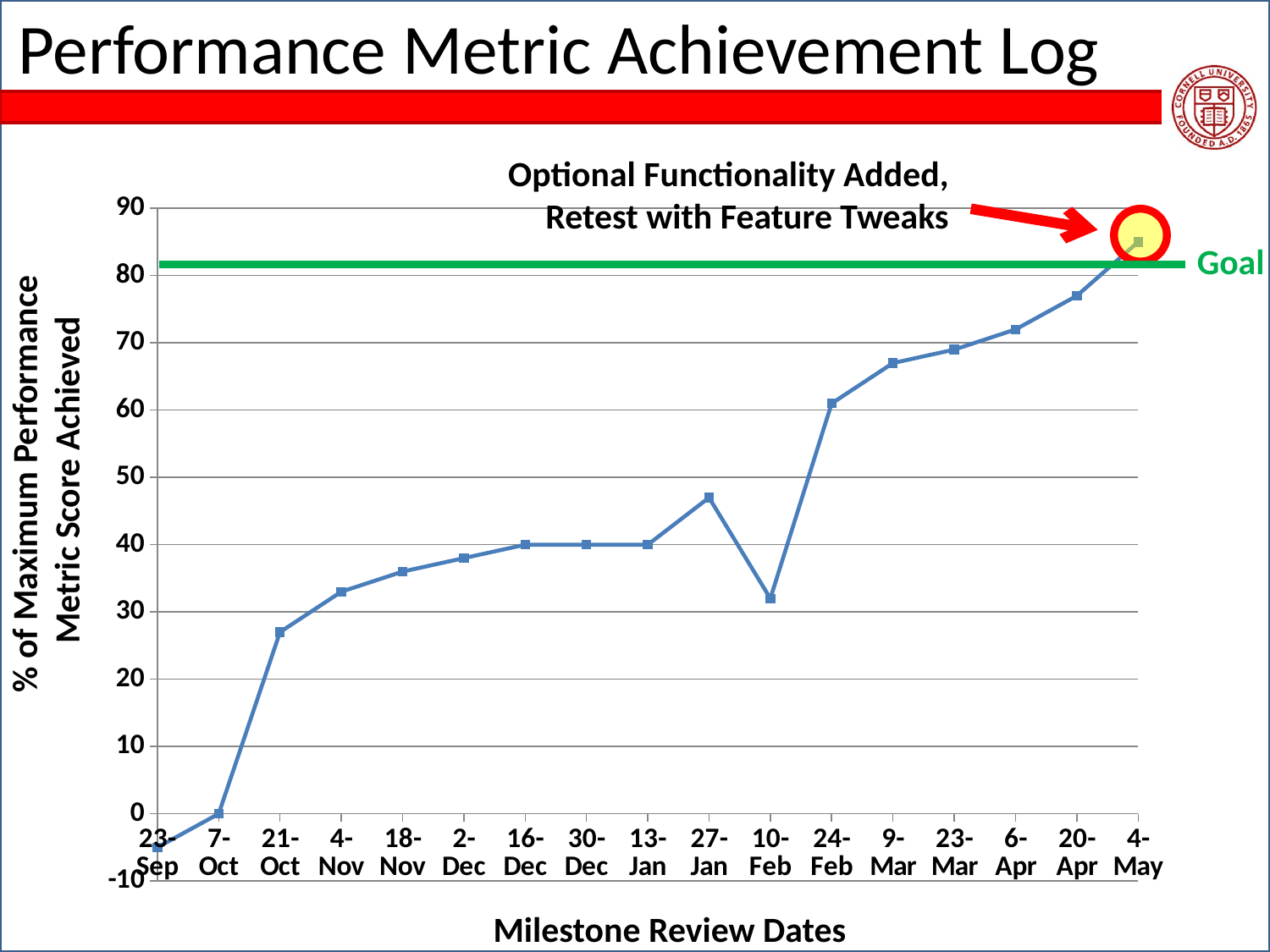
Is the value for 10-Feb greater or less than 40? less What is the value for 7-Oct? 0 Which milestone review date has the lowest value? 23-Sep How many milestone review dates are plotted on the x axis? 17 What is the value for 16-Dec? 40 Is the value for 4-May greater or less than 80? greater Which milestone review date has the highest value? 4-May What kind of chart is shown on the slide? line chart Which is larger, the value for 27-Jan or the value for 10-Feb? 27-Jan Do the values generally rise or fall from 23-Sep to 4-May? rise What is the title of the x axis? Milestone Review Dates